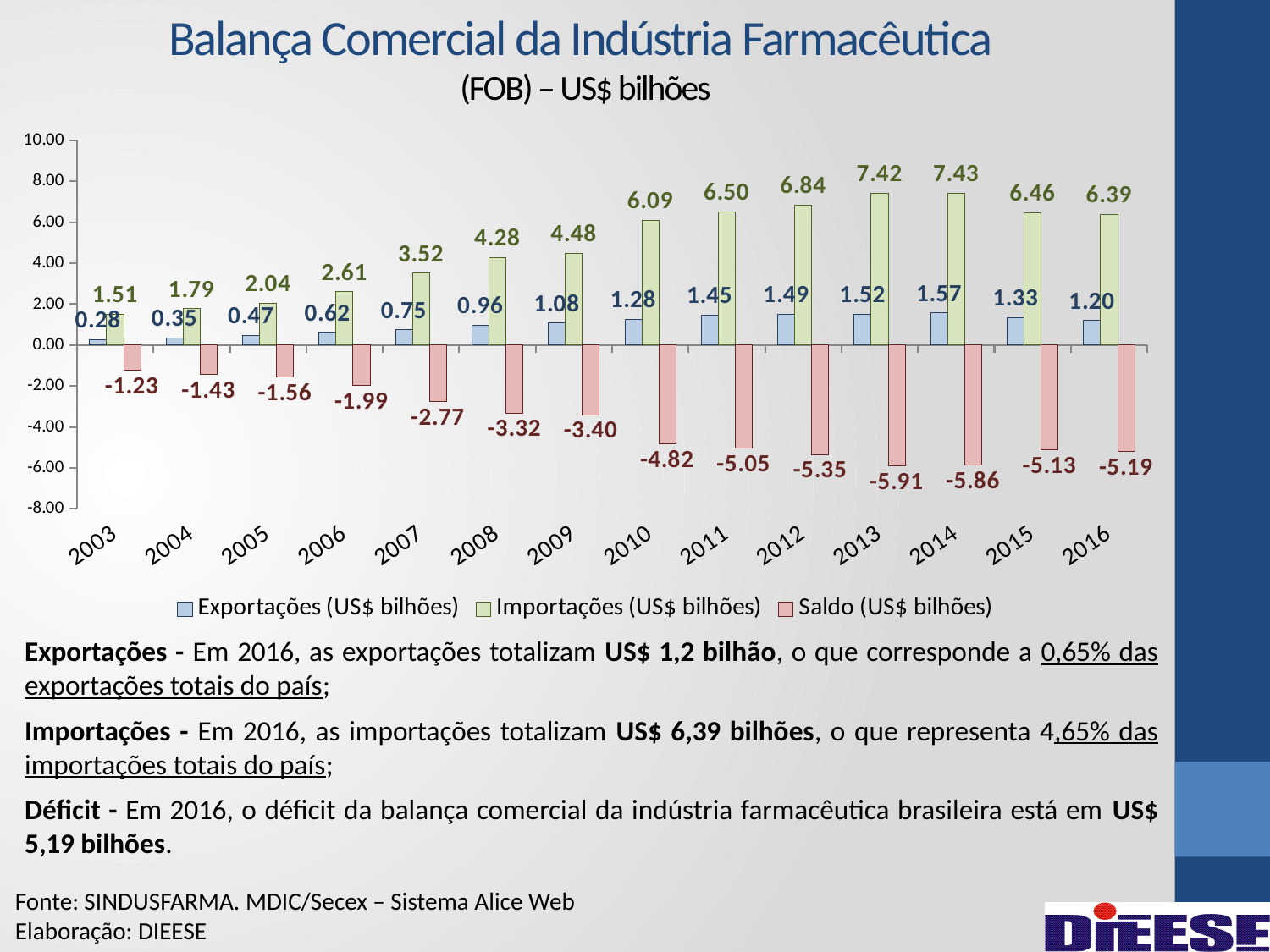
What kind of chart is shown on the slide? Bar chart What is the value of Saldo (US$ bilhões) in 2013? -5.91 In which year is the value of Exportações (US$ bilhões) the highest? 2014 How many years are shown on the x axis of the chart? 14 What is the title of the chart? Balança Comercial da Indústria Farmacêutica (FOB) – US$ bilhões How many series does the legend list? 3 In which year is the value of Importações (US$ bilhões) the lowest? 2003 What is the value of Exportações (US$ bilhões) in 2014? 1.57 What is the value of Importações (US$ bilhões) in 2010? 6.09 Which year has the larger value of Importações (US$ bilhões), 2008 or 2009? 2009 Do the values of Importações (US$ bilhões) rise or fall from 2003 to 2014? Rise What is the difference between Importações and Exportações in 2016? 5.19